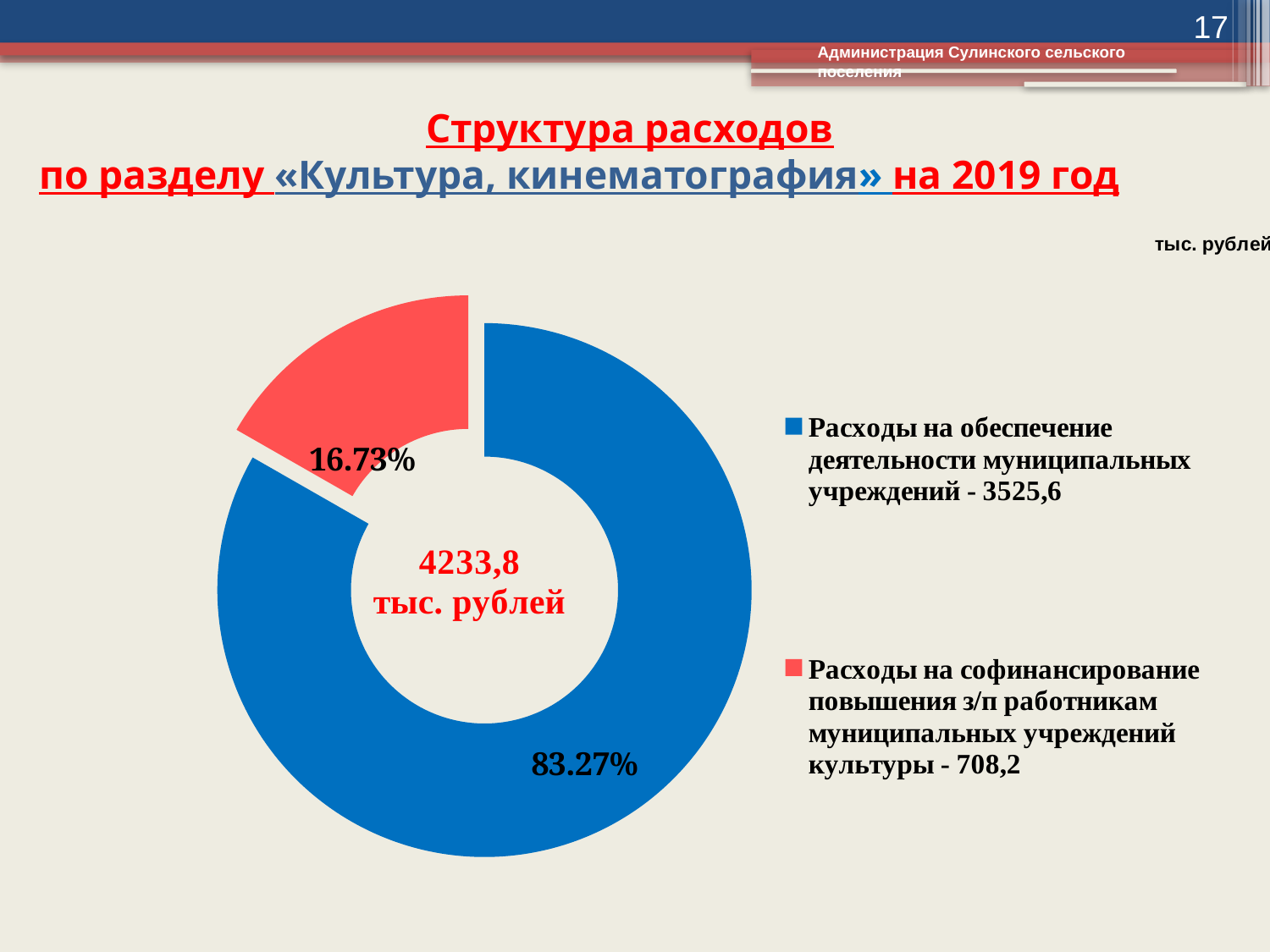
Which slice is the smallest in the pie chart? Расходы на софинансирование повышения з/п работникам муниципальных учреждений культуры What is the value for 'Расходы на обеспечение деятельности муниципальных учреждений' according to the legend? 3525,6 Which slice is the largest in the pie chart? Расходы на обеспечение деятельности муниципальных учреждений What is the value for 'Расходы на софинансирование повышения з/п работникам муниципальных учреждений культуры' according to the legend? 708,2 How many slices does the pie chart have? 2 What unit of measurement is indicated above the chart? тыс. рублей What share of the pie does the slice 'Расходы на софинансирование повышения з/п работникам муниципальных учреждений культуры' take? 16.73% What share of the pie does the slice 'Расходы на обеспечение деятельности муниципальных учреждений' take? 83.27% Which colour represents 'Расходы на софинансирование повышения з/п работникам муниципальных учреждений культуры'? Red What kind of chart is shown on the slide? Pie chart (doughnut) What is the difference between the two values shown in the legend, 3525,6 and 708,2? 2817,4 What total amount is shown in the centre of the doughnut chart? 4233,8 тыс. рублей